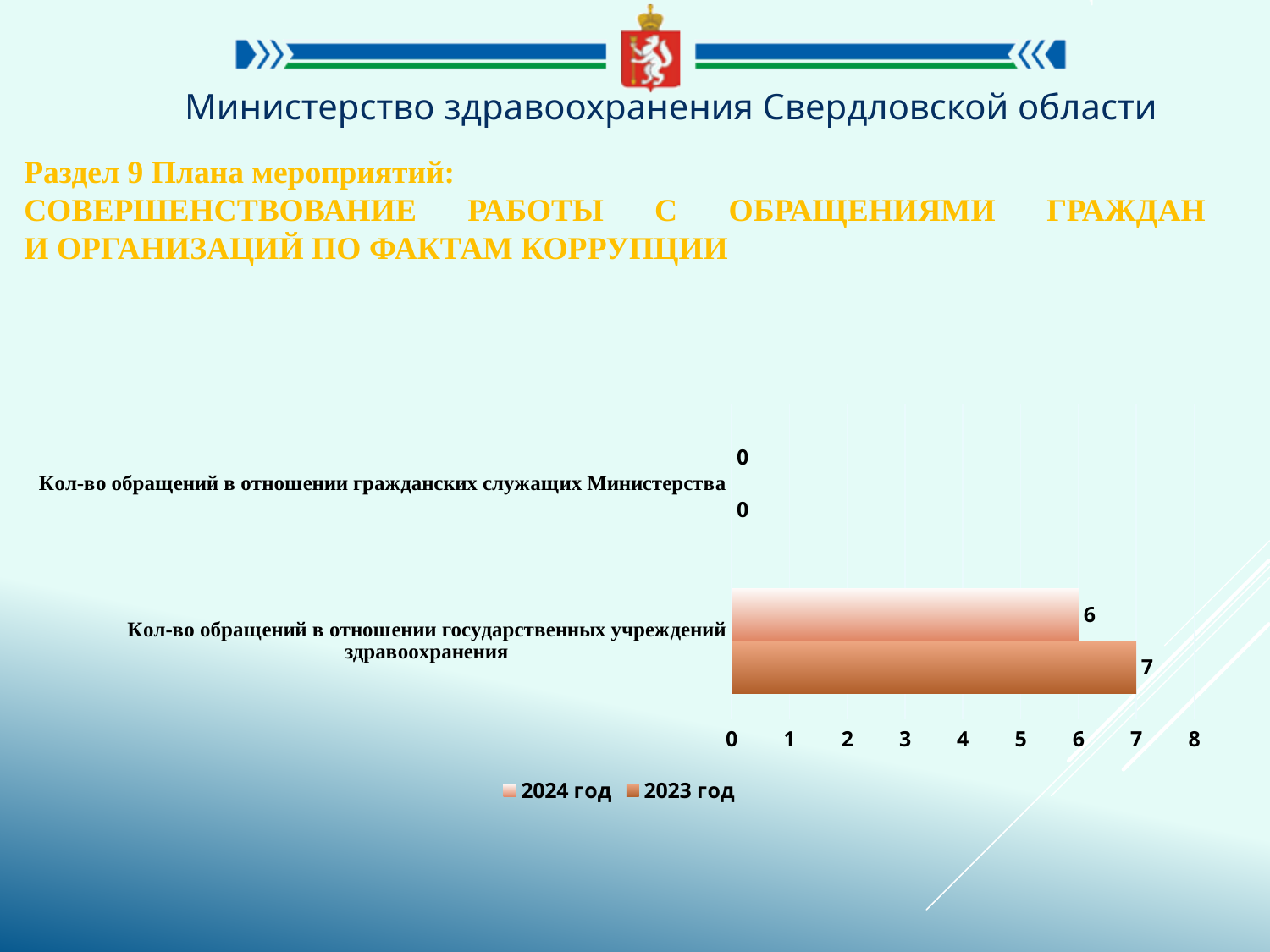
What is the value for 2024 год for "Кол-во обращений в отношении гражданских служащих Министерства"? 0 What are the two series names listed in the legend? 2024 год and 2023 год What kind of chart is shown on the slide? bar chart Is the 2023 год value for "Кол-во обращений в отношении государственных учреждений здравоохранения" greater or less than 5? greater How many categories are shown on the chart? 2 What is the difference between the 2023 год and 2024 год values for "Кол-во обращений в отношении государственных учреждений здравоохранения"? 1 What is the value for 2024 год for "Кол-во обращений в отношении государственных учреждений здравоохранения"? 6 What is the value for 2023 год for "Кол-во обращений в отношении государственных учреждений здравоохранения"? 7 For "Кол-во обращений в отношении государственных учреждений здравоохранения", which series has the larger value, 2024 год or 2023 год? 2023 год Which category has the highest value in the 2023 год series? Кол-во обращений в отношении государственных учреждений здравоохранения What is the value for 2023 год for "Кол-во обращений в отношении гражданских служащих Министерства"? 0 How many series does the legend list? 2